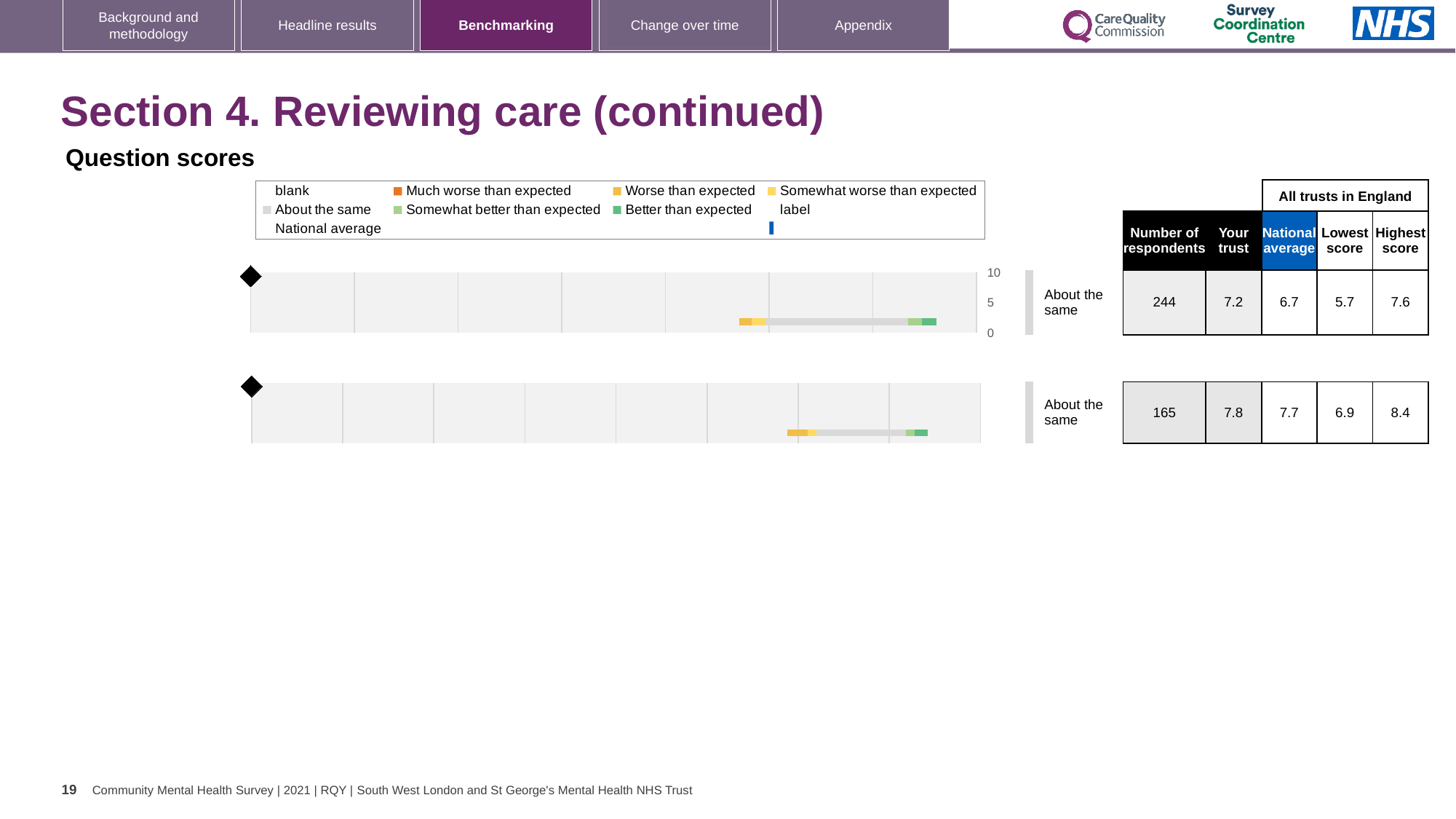
For the bottom chart, what is the highest score among all trusts in England? 8.4 For the bottom chart, what is the difference between the highest score and the lowest score? 1.5 How many question score charts are shown on the slide? 2 For the top chart, what is the difference between the 'Your trust' score and the national average? 0.5 What benchmark category is shown next to the bottom chart? About the same For the top chart, what is the 'Your trust' score shown in the table? 7.2 What kind of chart is used on this slide to show the question scores? Bar chart For the top chart, which is larger: the 'Your trust' score or the national average? Your trust For the bottom chart, what is the lowest score among all trusts in England? 6.9 For the top chart, how many respondents are listed? 244 What is the maximum value shown on the score axis of the top chart? 10 For the top chart, what is the national average score? 6.7